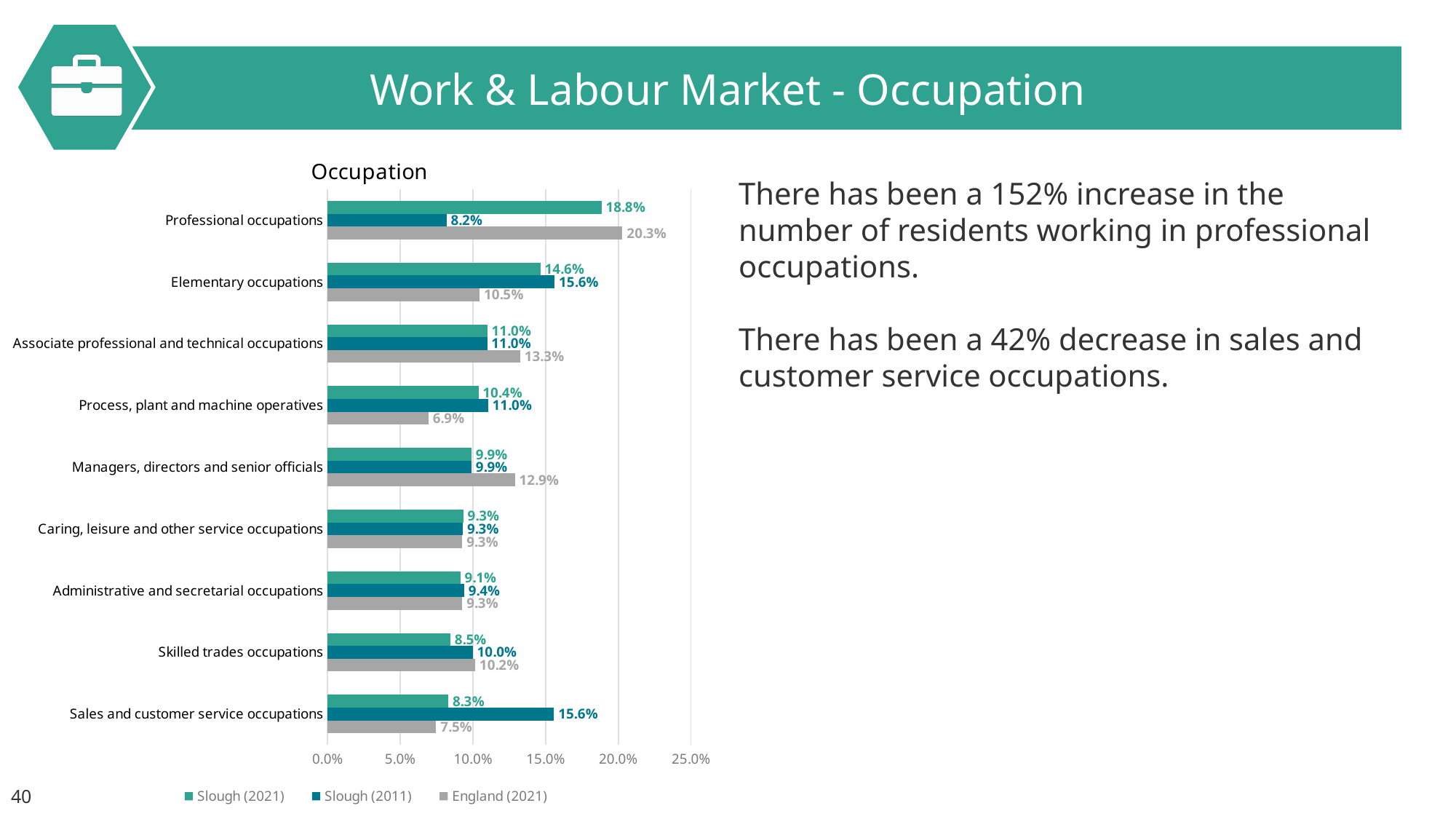
What is the England (2021) value for Process, plant and machine operatives? 6.9% How many series does the legend list? 3 Which is larger for Skilled trades occupations: the Slough (2021) value or the Slough (2011) value? Slough (2011) What is the Slough (2021) value for Professional occupations? 18.8% What type of chart is shown on the slide? Bar chart What is the title of the chart? Occupation What is the Slough (2011) value for Sales and customer service occupations? 15.6% Which occupation has the highest Slough (2021) value? Professional occupations Is the England (2021) value for Professional occupations greater or less than 20.0%? greater How many occupation categories are shown in the chart? 9 What is the difference between the Slough (2021) and Slough (2011) values for Professional occupations? 10.6% Which occupation has the lowest England (2021) value? Process, plant and machine operatives